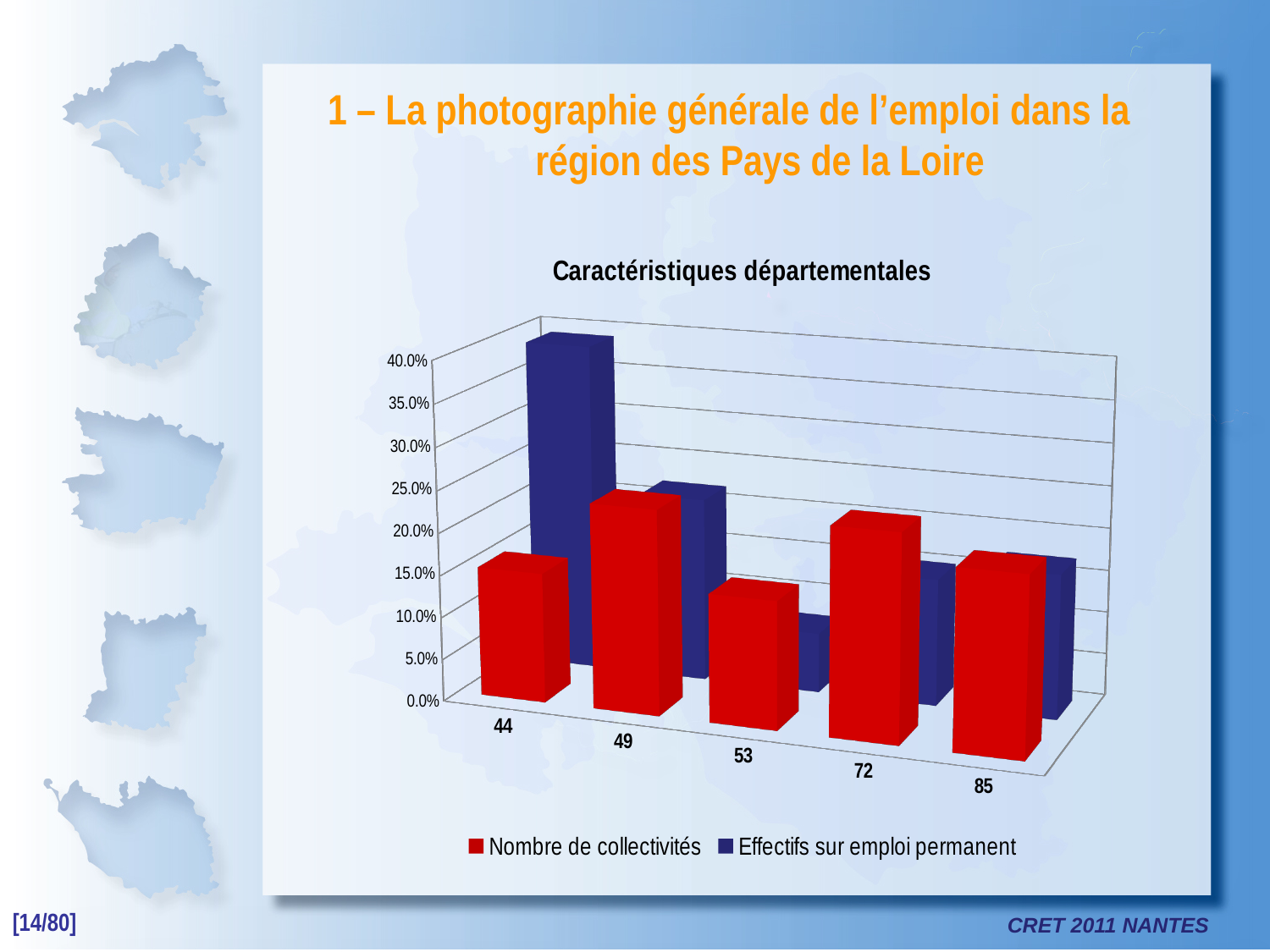
Which category has the lowest value for Effectifs sur emploi permanent? 53 Is the value of Effectifs sur emploi permanent for category 44 greater or less than 30.0%? greater What is the title of the chart? Caractéristiques départementales For category 44, which series has the larger value, Nombre de collectivités or Effectifs sur emploi permanent? Effectifs sur emploi permanent How many series does the chart legend list? 2 For category 53, which series has the larger value, Nombre de collectivités or Effectifs sur emploi permanent? Nombre de collectivités Which category has the highest value for Effectifs sur emploi permanent? 44 Is the value of Nombre de collectivités for category 53 greater or less than 20.0%? less Which series is shown in red in the chart? Nombre de collectivités How many categories are shown on the x axis of the chart? 5 What kind of chart is shown on the slide? bar chart